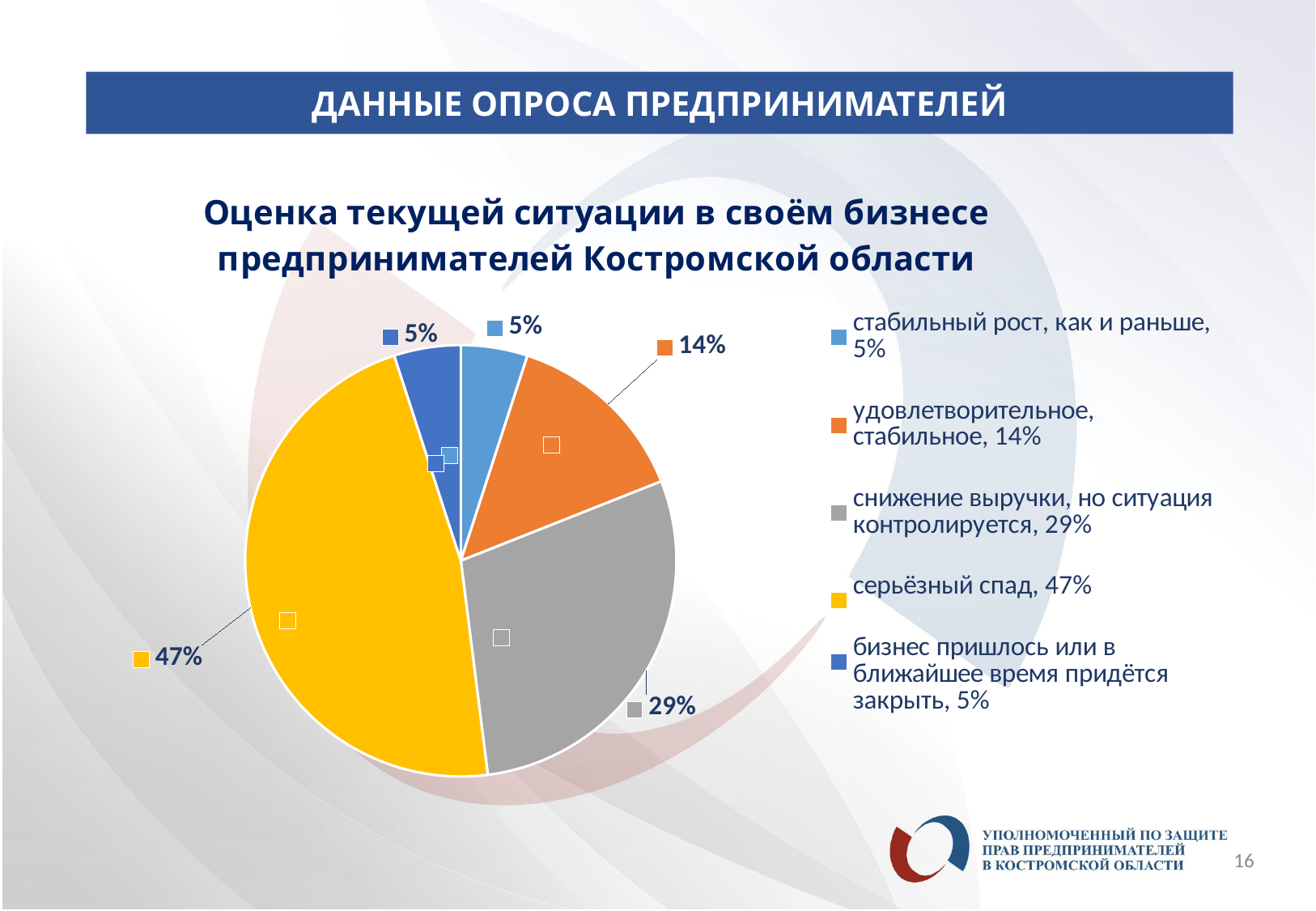
What colour is the slice for "серьёзный спад"? yellow How many slices does the pie chart have? 5 Which category has the largest share of the pie? серьёзный спад What is the title of the chart? Оценка текущей ситуации в своём бизнесе предпринимателей Костромской области Which is larger: the share for "удовлетворительное, стабильное" or the share for "снижение выручки, но ситуация контролируется"? снижение выручки, но ситуация контролируется What share of respondents chose "стабильный рост, как и раньше"? 5% What share of respondents chose "снижение выручки, но ситуация контролируется"? 29% What share of respondents chose "серьёзный спад"? 47% What share of respondents chose "бизнес пришлось или в ближайшее время придётся закрыть"? 5% What is the difference in percentage points between "серьёзный спад" and "снижение выручки, но ситуация контролируется"? 18 What share of respondents chose "удовлетворительное, стабильное"? 14% What type of chart is shown on the slide? pie chart